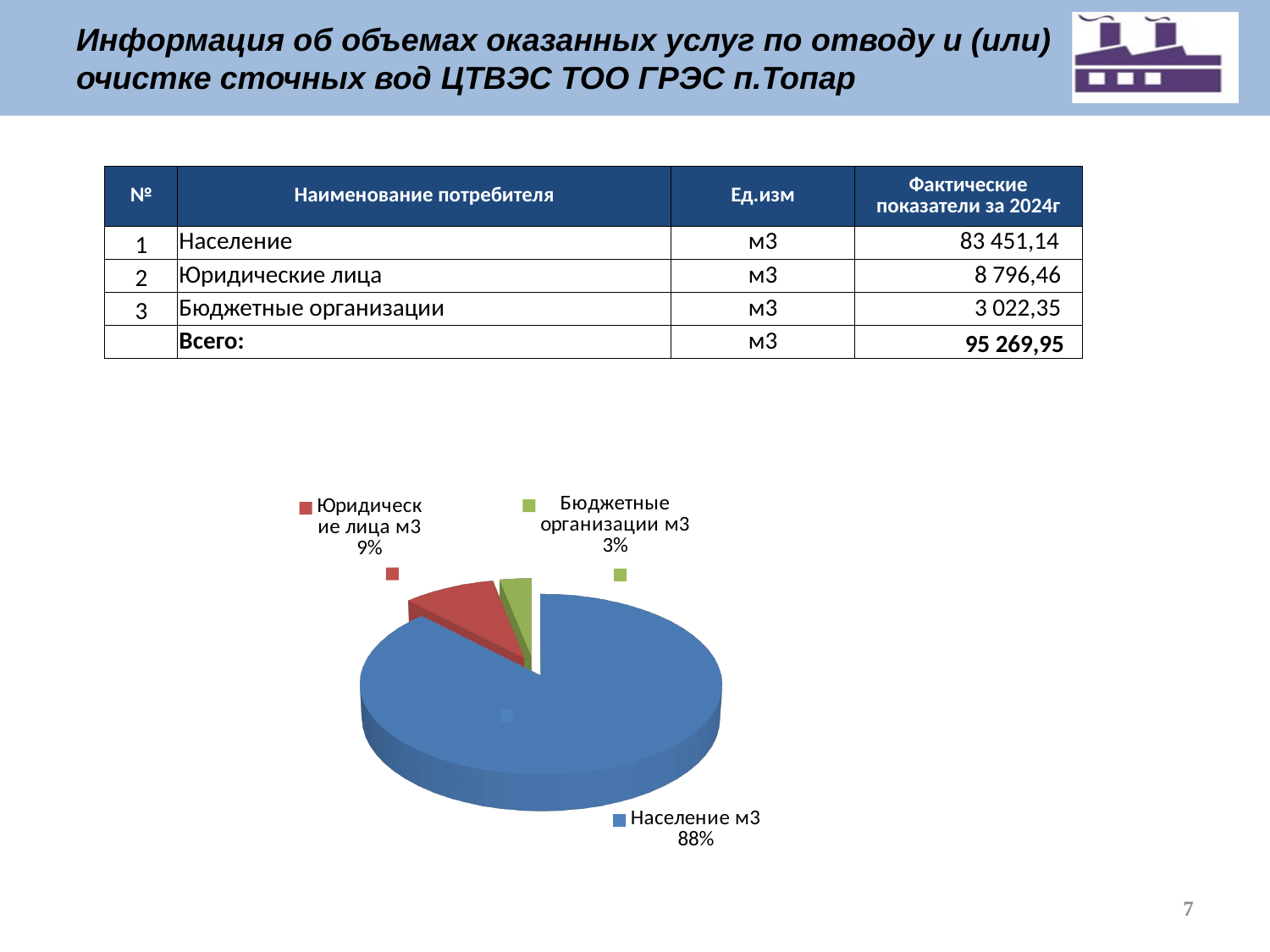
By how many percentage points does the share of "Юридические лица м3" exceed the share of "Бюджетные организации м3" in the pie chart? 6 By how many percentage points does the share of "Население м3" exceed the share of "Юридические лица м3" in the pie chart? 79 How many slices does the pie chart have? 3 What share of the pie does the slice "Население м3" represent? 88% What colour is the slice for "Юридические лица м3" in the pie chart? red Which slice is larger in the pie chart: "Юридические лица м3" or "Бюджетные организации м3"? Юридические лица м3 Which slice of the pie chart is the smallest? Бюджетные организации м3 What kind of chart is shown on the slide? pie chart What share of the pie does the slice "Бюджетные организации м3" represent? 3% What share of the pie does the slice "Юридические лица м3" represent? 9% What colour is the slice for "Население м3" in the pie chart? blue Which slice of the pie chart is the largest? Население м3